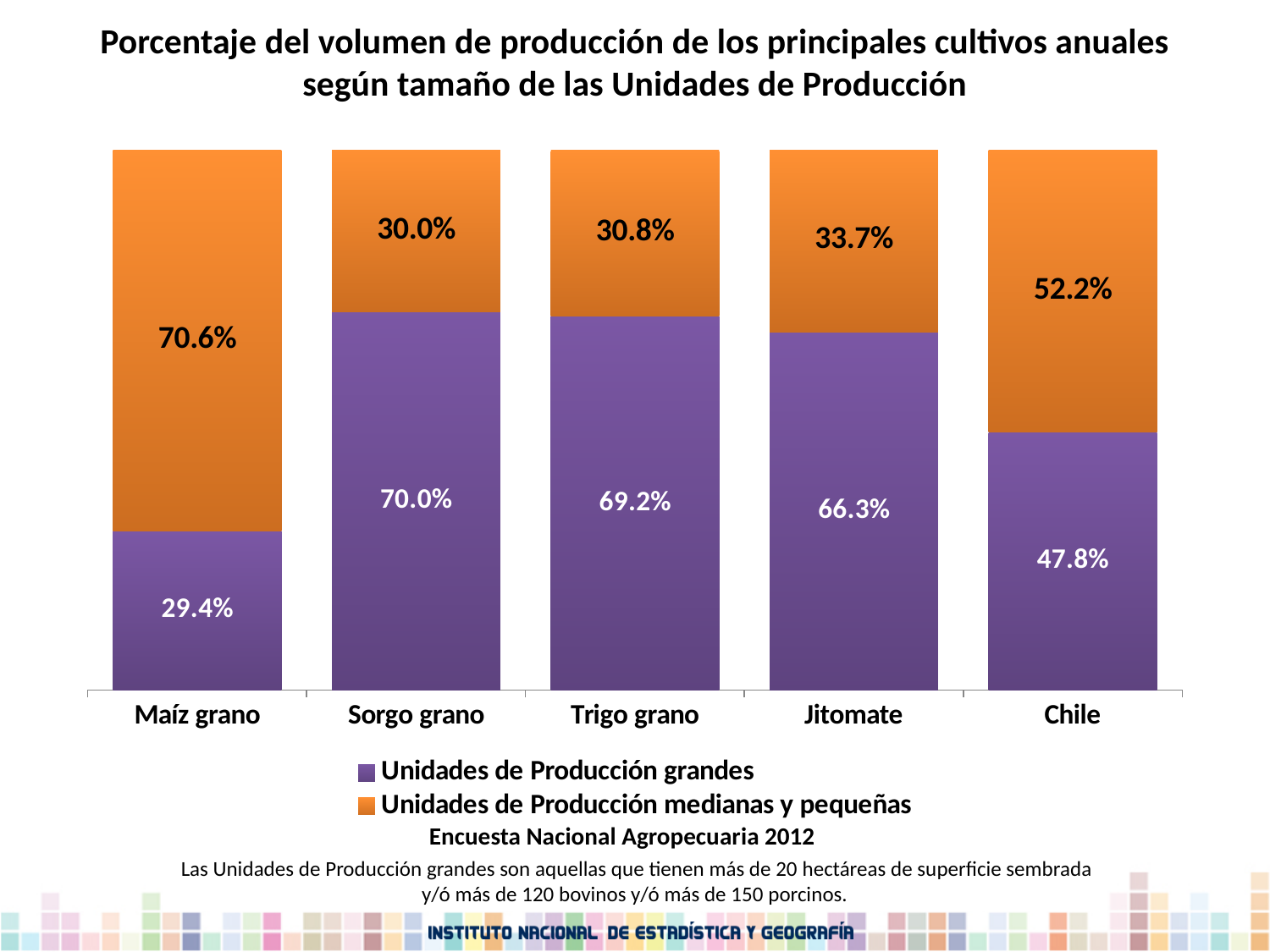
How many crops are shown on the x axis? 5 What kind of chart is shown? Stacked bar chart What is the difference between the Unidades de Producción grandes values for Sorgo grano and Chile? 22.2% What is the value for Unidades de Producción grandes for Jitomate? 66.3% Which colour represents Unidades de Producción grandes? Purple Which is larger: the Unidades de Producción medianas y pequeñas value for Maíz grano or for Chile? Maíz grano What is the total of the stacked bar for Trigo grano? 100.0% What is the value for Unidades de Producción grandes for Maíz grano? 29.4% How many series does the legend list? 2 What is the value for Unidades de Producción medianas y pequeñas for Chile? 52.2% Which crop has the highest value for Unidades de Producción grandes? Sorgo grano Which crop has the lowest value for Unidades de Producción medianas y pequeñas? Sorgo grano